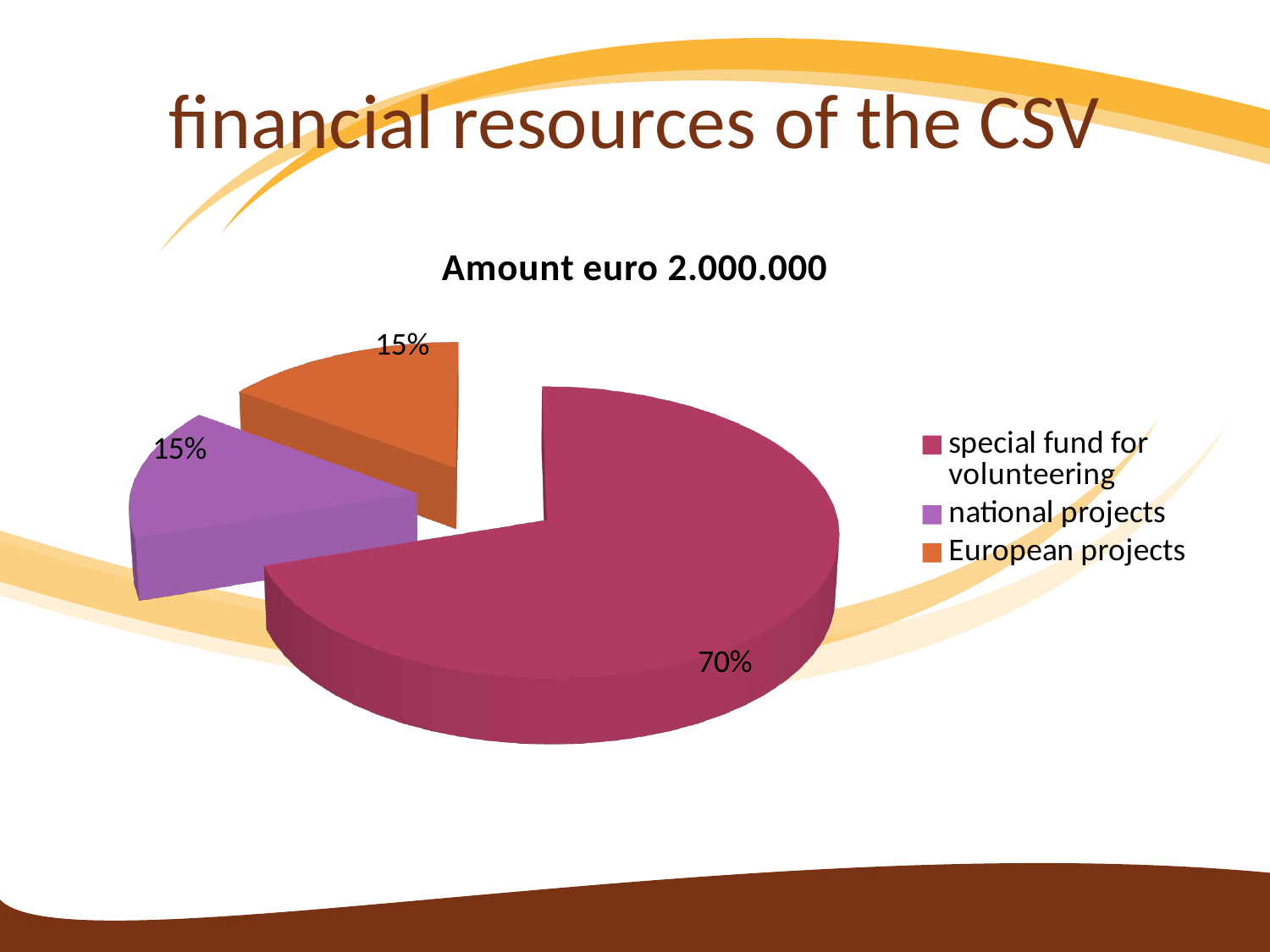
Which is larger, the share for the special fund for volunteering or the share for European projects? special fund for volunteering How many slices does the pie chart have? 3 What kind of chart is shown on the slide? pie chart What share of the pie do national projects take? 15% Which colour represents European projects in the legend? orange How many entries does the legend list? 3 What is the combined share of national projects and European projects? 30% What share of the pie does the special fund for volunteering take? 70% What share of the pie do European projects take? 15% What is the difference between the share for the special fund for volunteering and the share for national projects? 55% Which category has the largest slice of the pie? special fund for volunteering What is the chart's title? Amount euro 2.000.000